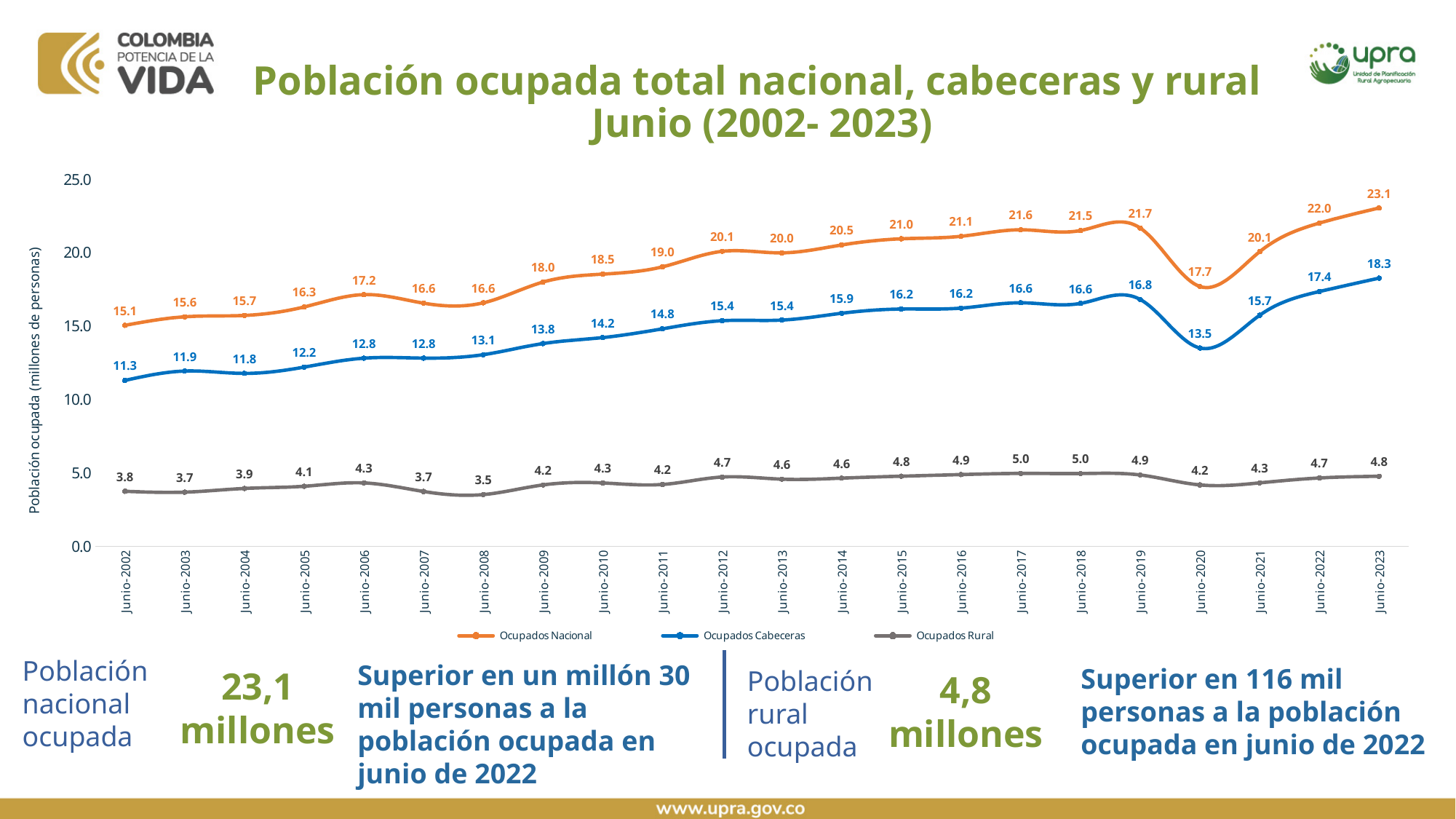
What is the value of Ocupados Rural for Junio-2008? 3.5 In which year does the Ocupados Nacional series reach its highest value? Junio-2023 What kind of chart is shown on the slide? line chart In which year does the Ocupados Rural series reach its lowest value? Junio-2008 How many series does the legend list? 3 By how much did Ocupados Nacional increase from Junio-2022 to Junio-2023? 1.1 What is the value of Ocupados Cabeceras for Junio-2020? 13.5 What is the value of Ocupados Nacional for Junio-2023? 23.1 Is the Ocupados Nacional value for Junio-2020 greater or less than 20.0? less Which is larger for Ocupados Cabeceras: the value for Junio-2019 or Junio-2021? Junio-2019 Does the Ocupados Cabeceras series rise or fall from Junio-2020 to Junio-2023? rise How many years (data points) are plotted along the x axis? 22